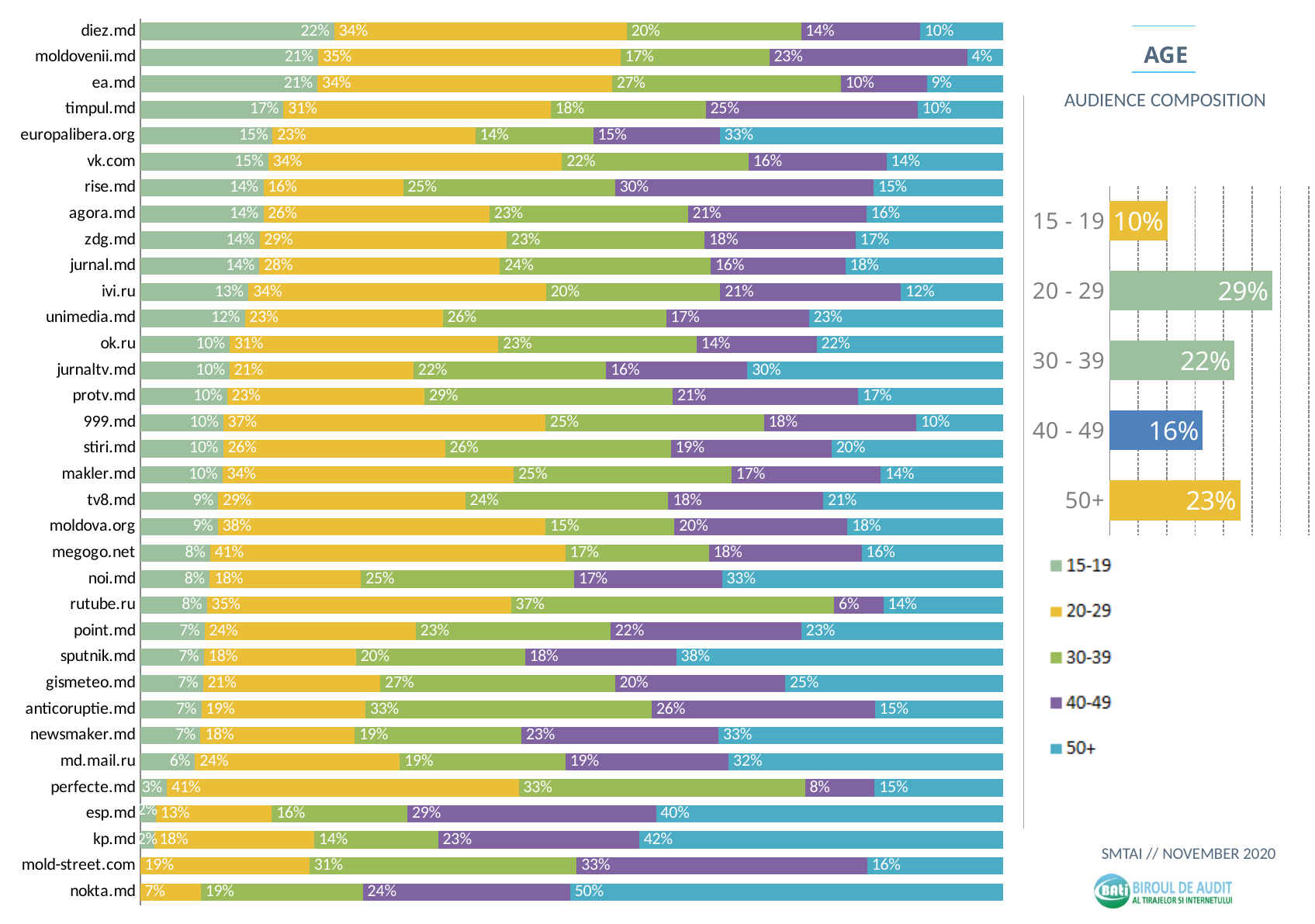
On the right-hand AGE chart, which age group has the lowest share? 15 - 19 On the left-hand audience composition chart, which has the larger 50+ share, sputnik.md or noi.md? sputnik.md On the left-hand audience composition chart, what share of rutube.ru's audience is aged 30-39? 37% On the right-hand AGE chart, what is the value for the 20 - 29 age group? 29% On the left-hand audience composition chart, how many series does the legend list? 5 On the right-hand AGE chart, what is the difference between the 20 - 29 and 15 - 19 values? 19 percentage points What kind of chart is the left-hand audience composition chart? Stacked bar chart On the right-hand AGE chart, how many age groups are shown? 5 On the right-hand AGE chart, which age group has the highest share? 20 - 29 On the left-hand audience composition chart, what share of diez.md's audience is aged 15-19? 22% On the left-hand audience composition chart, which colour represents the 50+ age group? Blue (teal) On the left-hand audience composition chart, what share of nokta.md's audience is aged 50+? 50%